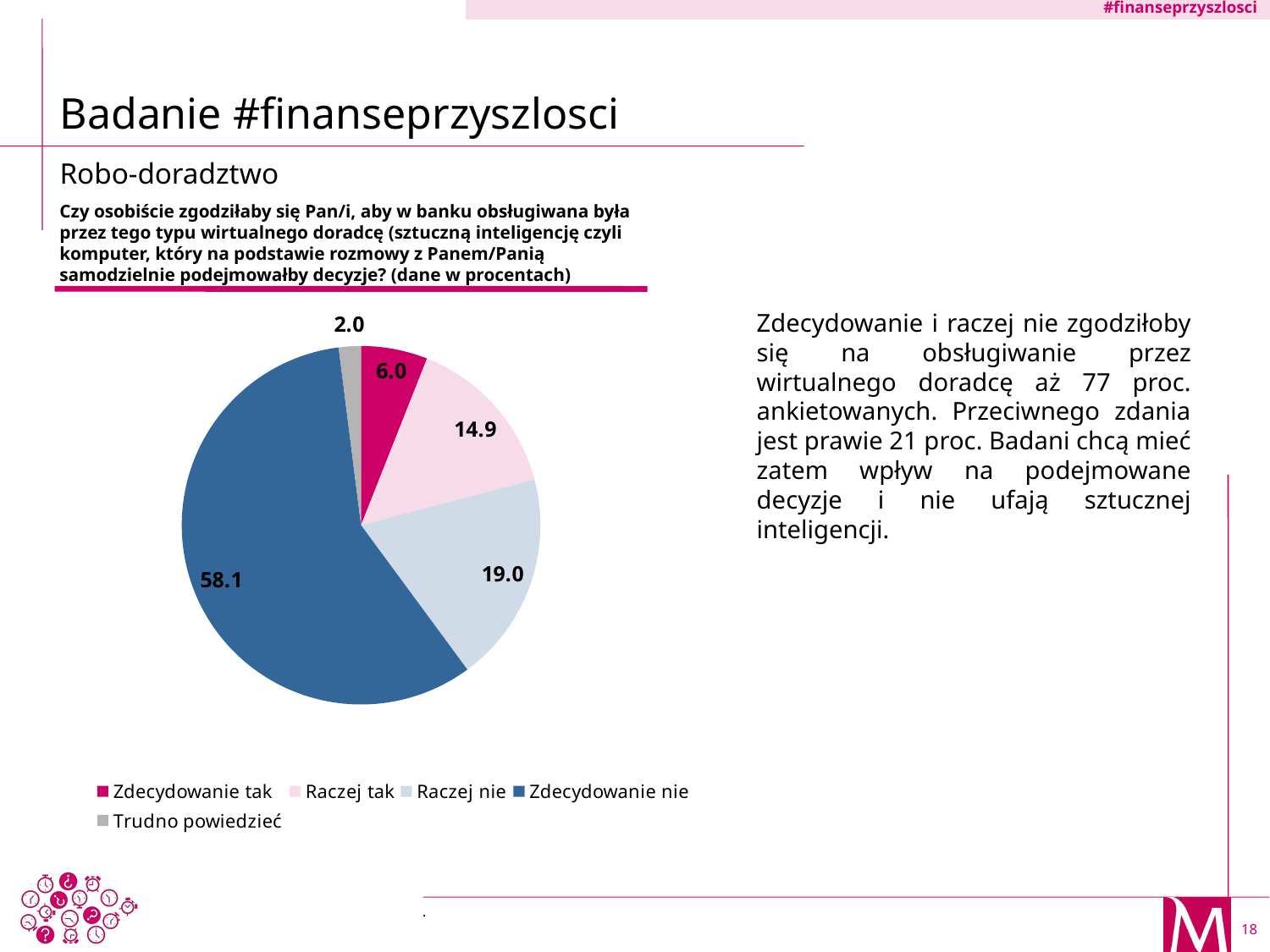
How many categories does the pie chart show? 5 Which is larger, the value for "Raczej nie" or the value for "Zdecydowanie tak"? Raczej nie Which legend entry is shown in dark blue? Zdecydowanie nie Which category has the smallest slice of the pie? Trudno powiedzieć What type of chart is shown on the slide? pie chart What is the value for "Zdecydowanie nie"? 58.1 What is the difference between the values for "Raczej nie" and "Raczej tak"? 4.1 What is the value for "Trudno powiedzieć"? 2.0 What is the value for "Zdecydowanie tak"? 6.0 What is the value for "Raczej tak"? 14.9 What is the combined value of "Zdecydowanie nie" and "Raczej nie"? 77.1 Which category has the largest slice of the pie? Zdecydowanie nie